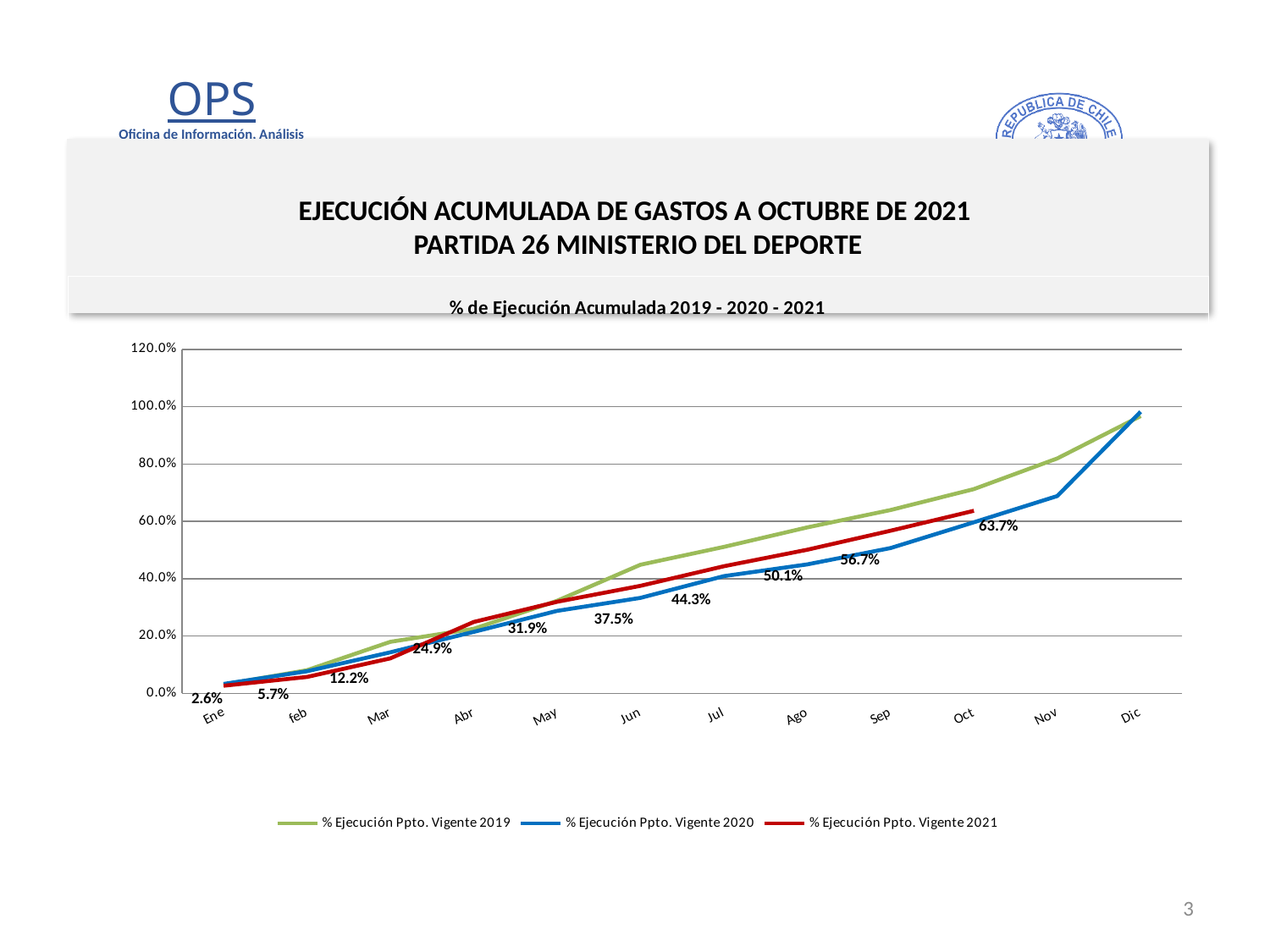
What is the value for % Ejecución Ppto. Vigente 2021 in Oct? 63.7% How many series does the legend list? 3 What is the value for % Ejecución Ppto. Vigente 2021 in Abr? 24.9% What is the value for % Ejecución Ppto. Vigente 2021 in Ene? 2.6% What type of chart is shown on the slide? line chart Which is larger in Sep: % Ejecución Ppto. Vigente 2019 or % Ejecución Ppto. Vigente 2020? % Ejecución Ppto. Vigente 2019 What is the title of the chart? % de Ejecución Acumulada 2019 - 2020 - 2021 What is the value for % Ejecución Ppto. Vigente 2021 in Jun? 37.5% What is the difference between the % Ejecución Ppto. Vigente 2021 values for Ago and Jul? 5.8% Does the % Ejecución Ppto. Vigente 2021 series rise or fall from Ene to Oct? rise Is the value for % Ejecución Ppto. Vigente 2019 in Dic greater or less than 80.0%? greater What is the difference between the % Ejecución Ppto. Vigente 2021 values for Oct and Sep? 7.0%